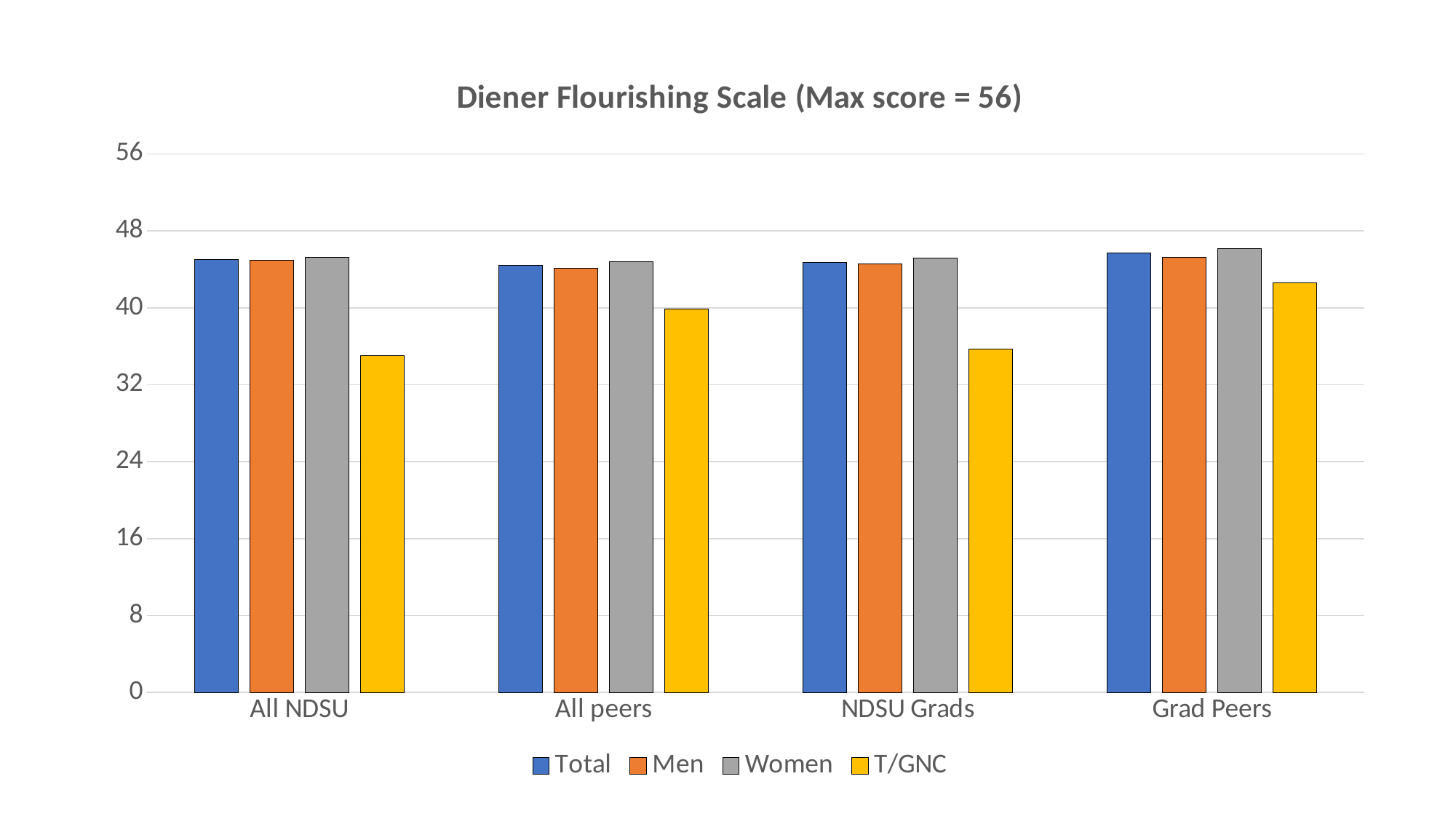
Is the Total value for All NDSU greater or less than 40? greater How many series does the legend list? 4 Which is larger in the NDSU Grads group: the Women value or the T/GNC value? Women Is the T/GNC value for Grad Peers greater or less than 40? greater Which series has the lowest value in the Grad Peers group? T/GNC How many categories are shown on the x axis? 4 Which series has the lowest value in the All NDSU group? T/GNC Which is larger: the T/GNC value for Grad Peers or the T/GNC value for All NDSU? Grad Peers What is the title of the chart? Diener Flourishing Scale (Max score = 56) Is the Women value for Grad Peers greater or less than 48? less What kind of chart is shown on the slide? bar chart